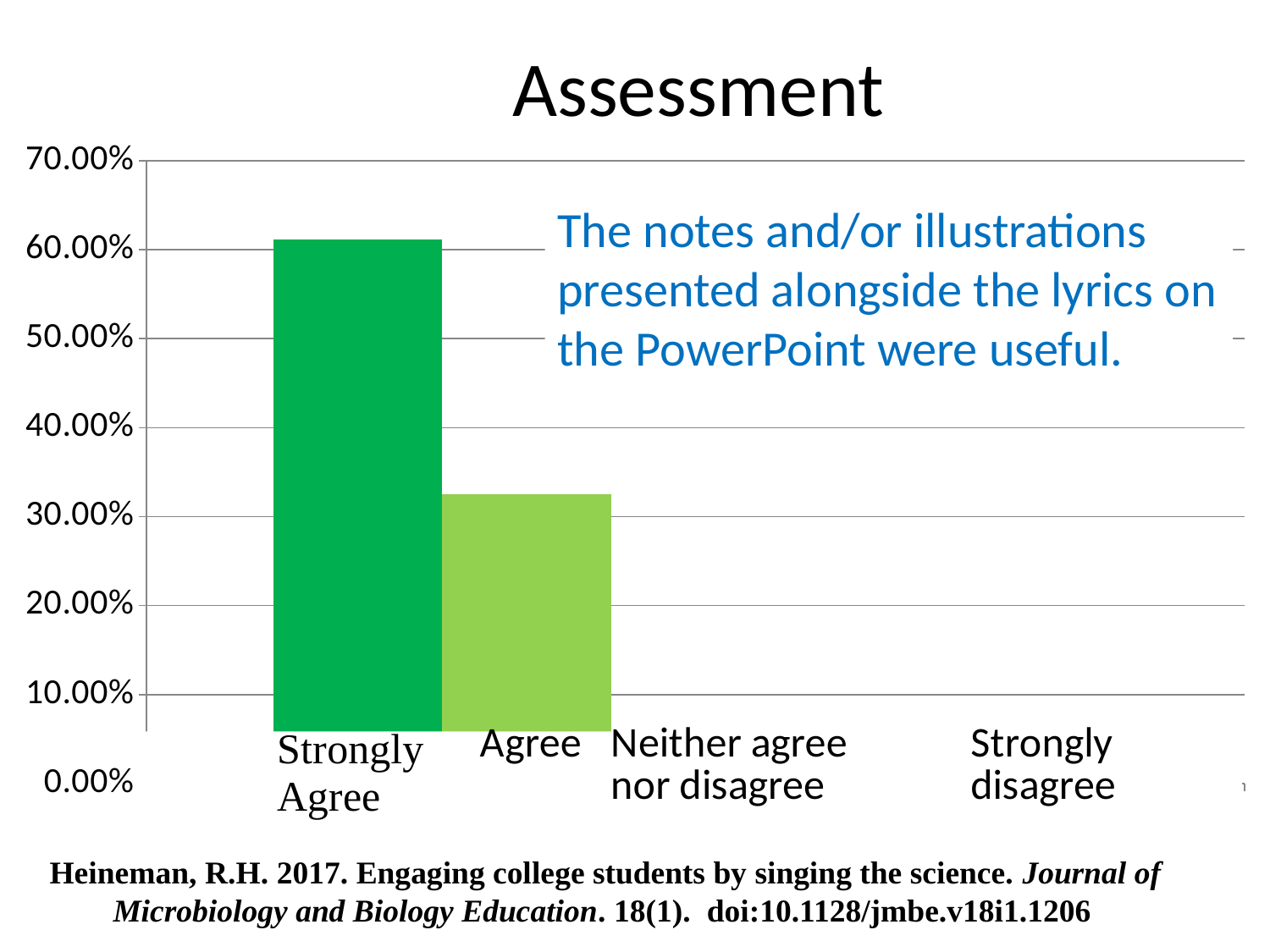
Is the value for Strongly Agree greater or less than 70.00%? less Is the value for Strongly Agree greater or less than 50.00%? greater Is the value for Agree greater or less than 20.00%? greater Which is larger, the value for Strongly Agree or the value for Agree? Strongly Agree Do the bar values rise or fall moving from Strongly Agree to Agree along the x axis? fall What kind of chart is shown on the slide? bar chart Which category has the highest value? Strongly Agree What survey statement is the chart about, as written on the slide? The notes and/or illustrations presented alongside the lyrics on the PowerPoint were useful. What is the highest value shown on the vertical axis? 70.00%